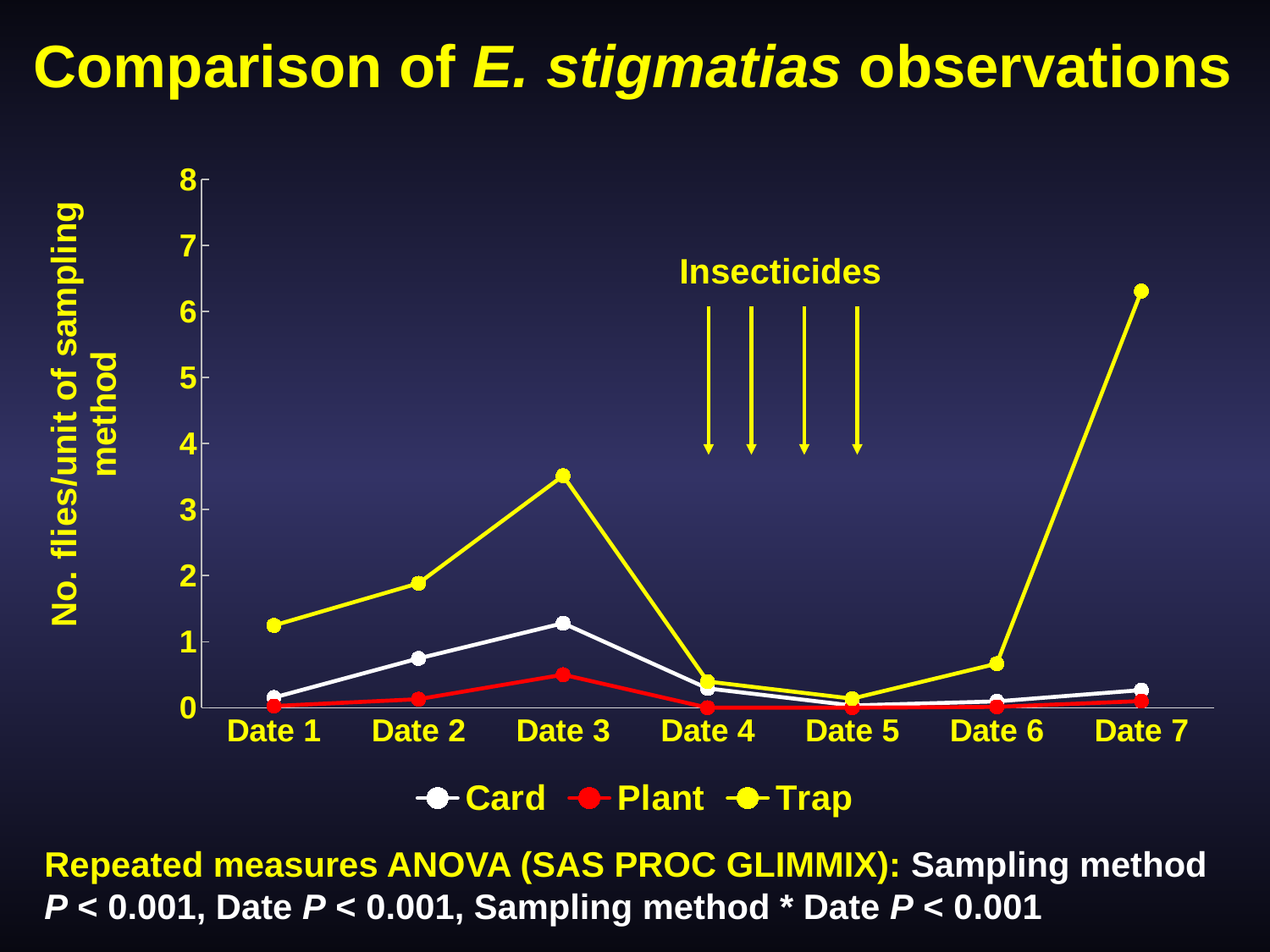
On which date does the Trap series reach its lowest value? Date 5 Is the value for Card at Date 3 greater or less than 1? greater Is the value for Trap at Date 7 greater or less than 6? greater Does the Trap series rise or fall from Date 3 to Date 4? fall Is the value for Plant at Date 3 greater or less than 1? less What annotation is written above the four arrows between Date 4 and Date 5? Insecticides Which series has the larger value at Date 2, Card or Trap? Trap How many series does the legend list? 3 What kind of chart is shown on the slide? line chart On which date does the Trap series reach its highest value? Date 7 How many dates are plotted along the x axis? 7